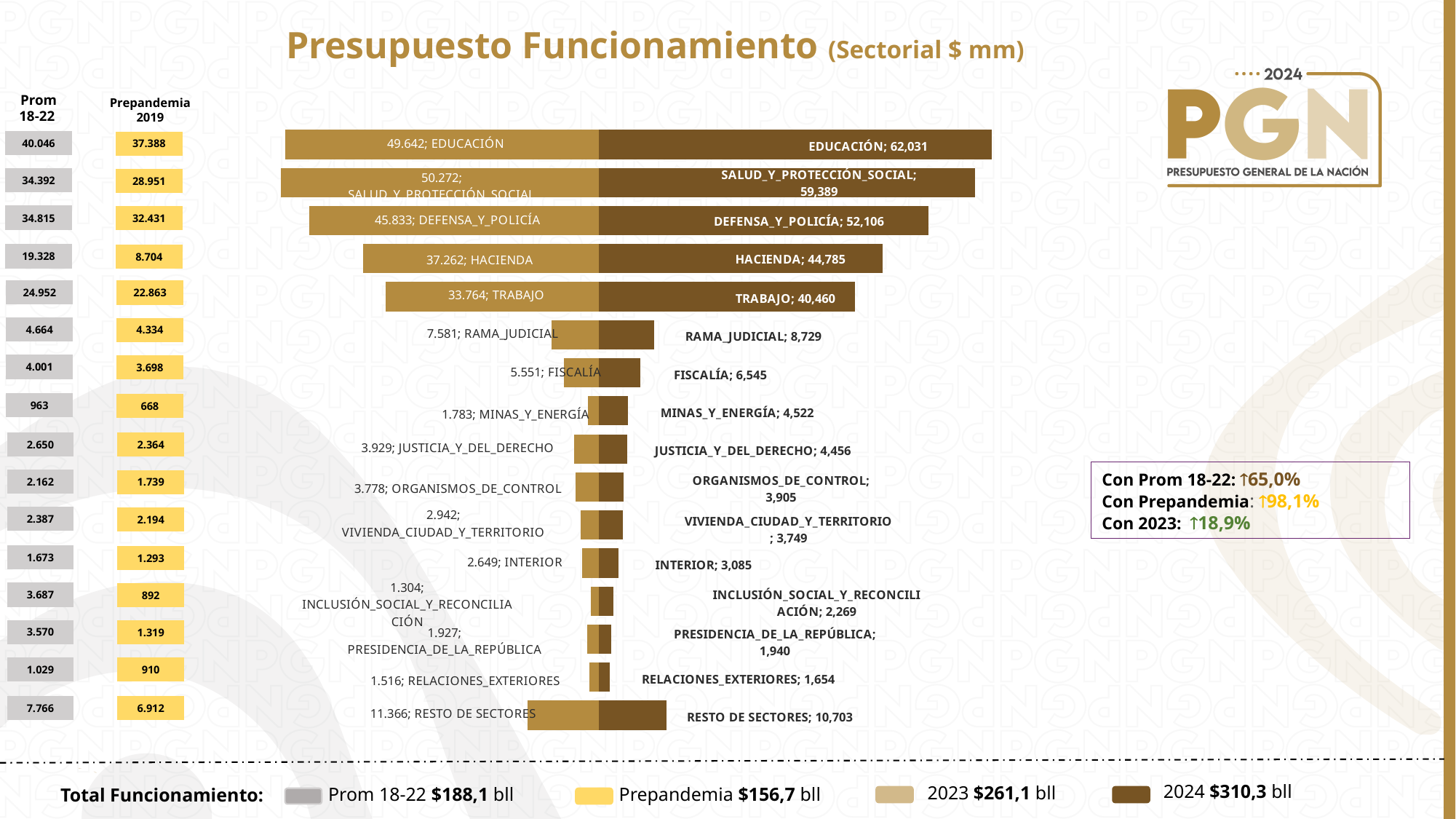
For RESTO DE SECTORES, which is larger: the 2023 value or the 2024 value? 2023 Which sector has the lowest 2023 value? INCLUSIÓN_SOCIAL_Y_RECONCILIACIÓN Which sector has the lowest 2024 value? RELACIONES_EXTERIORES What is the 2024 value for EDUCACIÓN? 62,031 What is the difference between the 2024 values for EDUCACIÓN and SALUD_Y_PROTECCIÓN_SOCIAL? 2,642 What is the title of the chart? Presupuesto Funcionamiento (Sectorial $ mm) How many sectors are plotted in the chart? 16 Which sector has the highest 2024 value? EDUCACIÓN What is the 2024 value for FISCALÍA? 6,545 What is the 2023 value for HACIENDA? 37.262 Which sector has the highest 2023 value? SALUD_Y_PROTECCIÓN_SOCIAL What kind of chart is shown on the slide? Bar chart